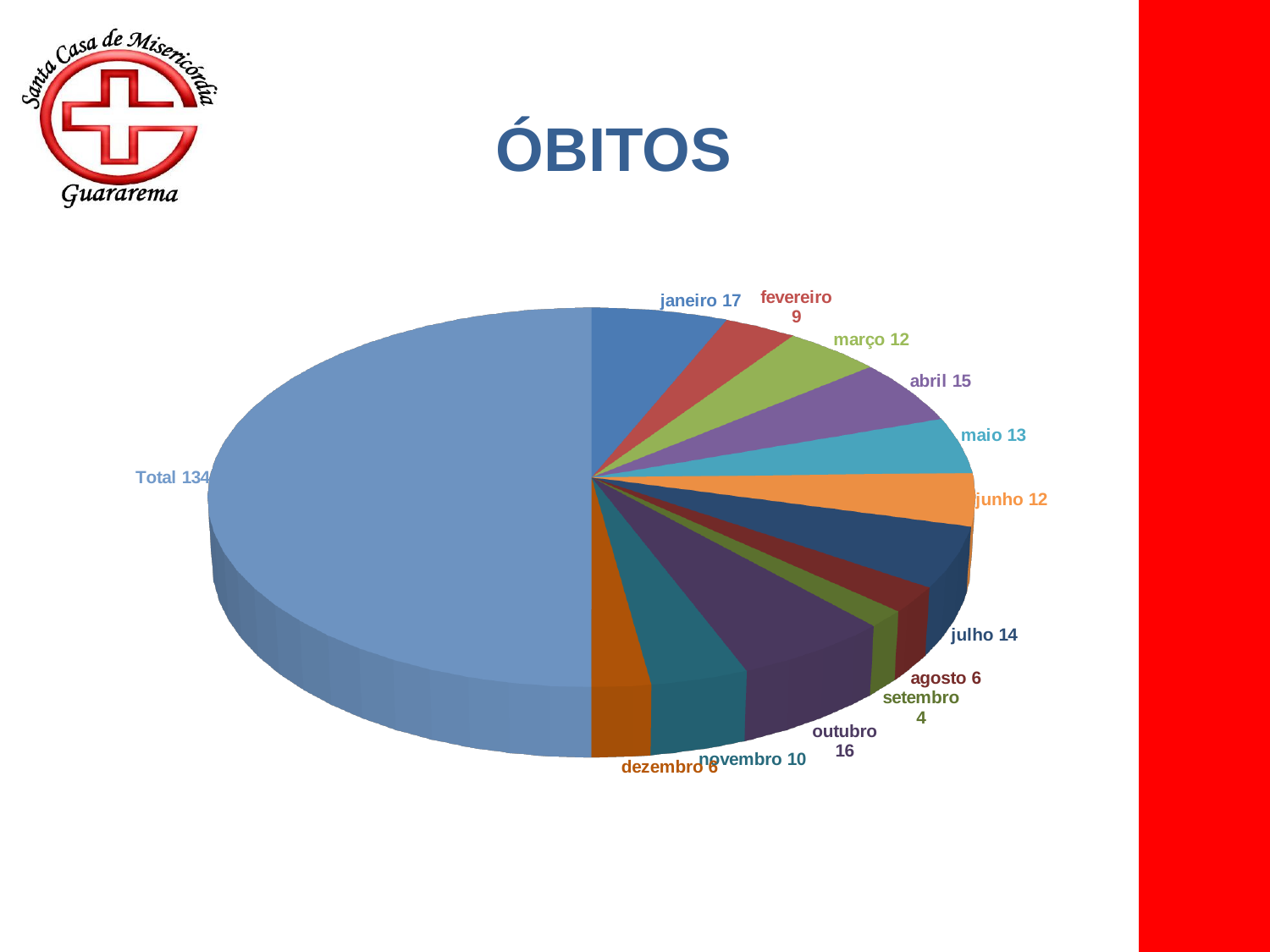
What is the value shown for abril? 15 Which month has the highest value? janeiro What is the value shown for janeiro? 17 How many months are labelled on the chart? 12 Which is larger, the value for maio or the value for junho? maio What is the value shown for setembro? 4 What is the difference between the values for janeiro and fevereiro? 8 What is the title of the chart? ÓBITOS What type of chart is shown on the slide? pie chart What is the value labelled as Total on the chart? 134 What is the value shown for outubro? 16 Which month has the lowest value? setembro